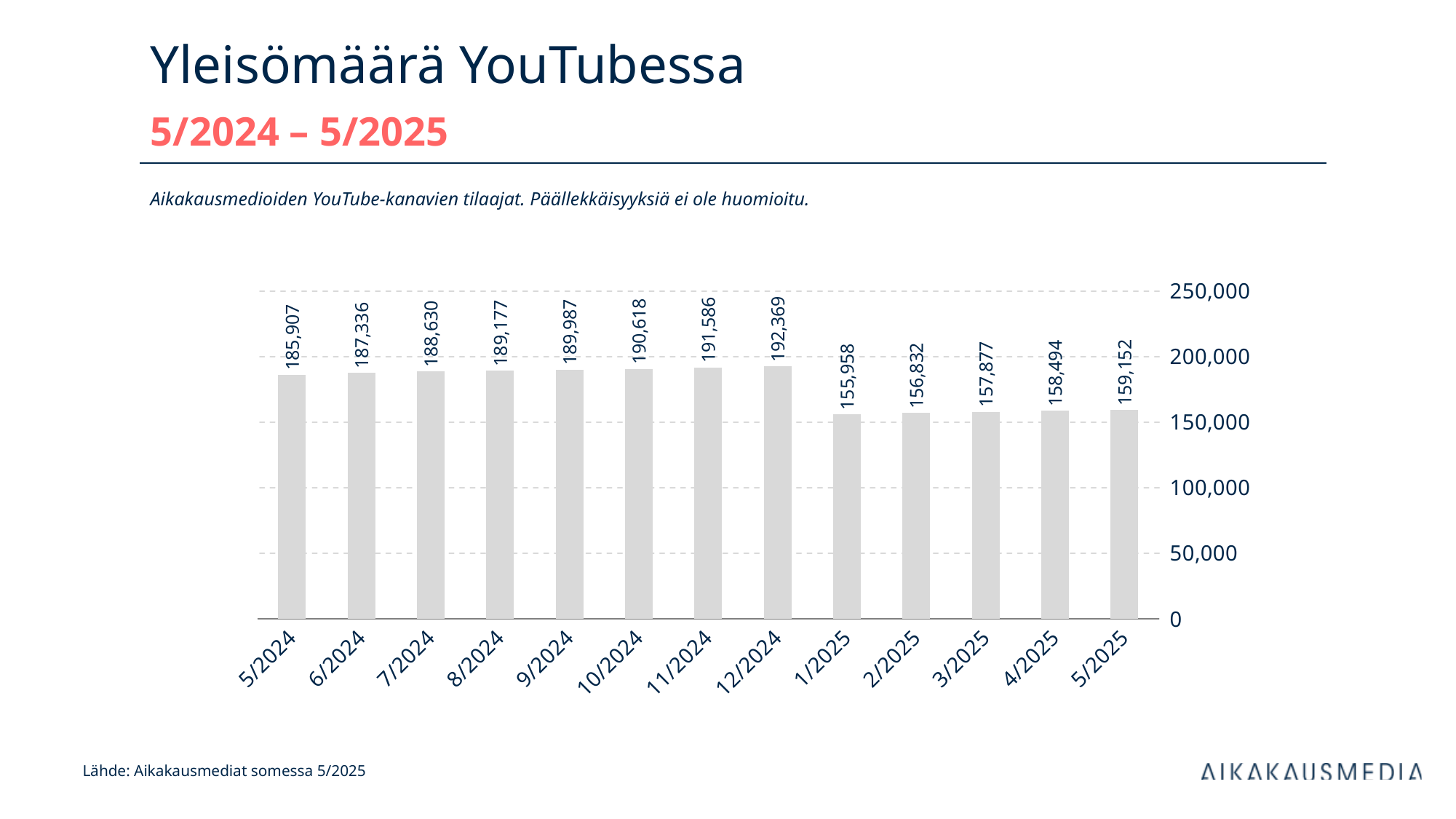
Which month has the highest value? 12/2024 What is the value for 5/2024? 185,907 What is the value for 5/2025? 159,152 Which month has the lowest value? 1/2025 What is the difference between the values for 12/2024 and 1/2025? 36,411 Which is larger, the value for 8/2024 or the value for 4/2025? 8/2024 What kind of chart is shown on the slide? bar chart Do the values rise or fall from 1/2025 to 5/2025? rise What is the value for 12/2024? 192,369 What is the value for 1/2025? 155,958 How many months are shown on the x axis? 13 Is the value for 3/2025 greater or less than 200,000? less